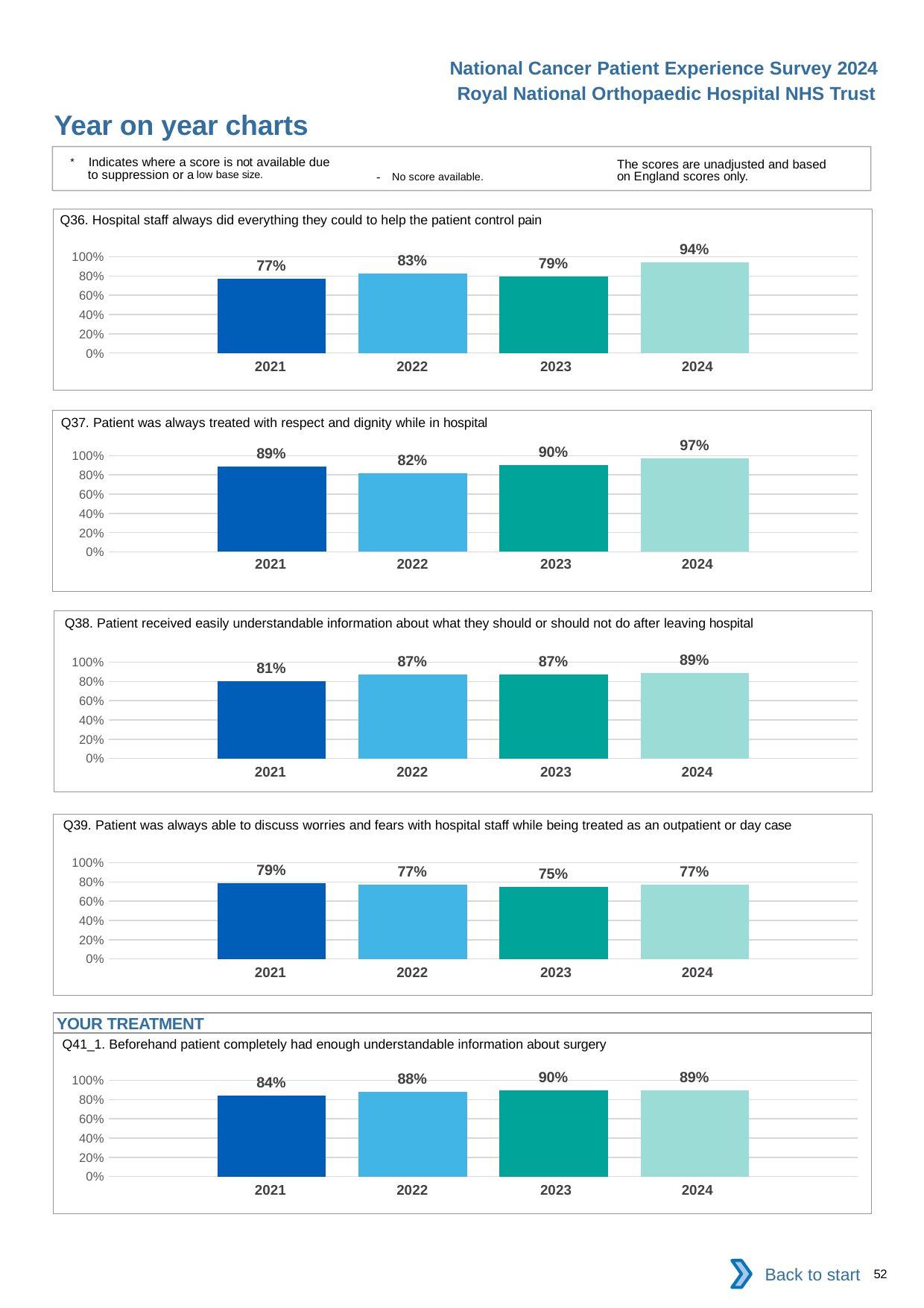
In the Q41_1 chart, what is the difference between the 2022 and 2021 values? 4% In the Q36 chart, which year has the lowest value? 2021 In the Q39 chart, is the value for 2021 larger or smaller than the value for 2023? larger In the Q39 chart (patient was always able to discuss worries and fears with hospital staff), which year has the lowest value? 2023 In the Q37 chart, what is the difference between the 2024 and 2021 values? 8% In the Q41_1 chart (beforehand patient completely had enough understandable information about surgery), what is the value for 2023? 90% In the Q38 chart (patient received easily understandable information about what they should or should not do after leaving hospital), what is the value for 2021? 81% What kind of chart is the Q37 chart? bar chart In the Q38 chart, which year has the highest value? 2024 How many years are shown on the x axis of the Q36 chart? 4 In the Q36 chart (hospital staff always did everything they could to help the patient control pain), what is the value for 2024? 94% In the Q37 chart (patient was always treated with respect and dignity while in hospital), what is the value for 2022? 82%